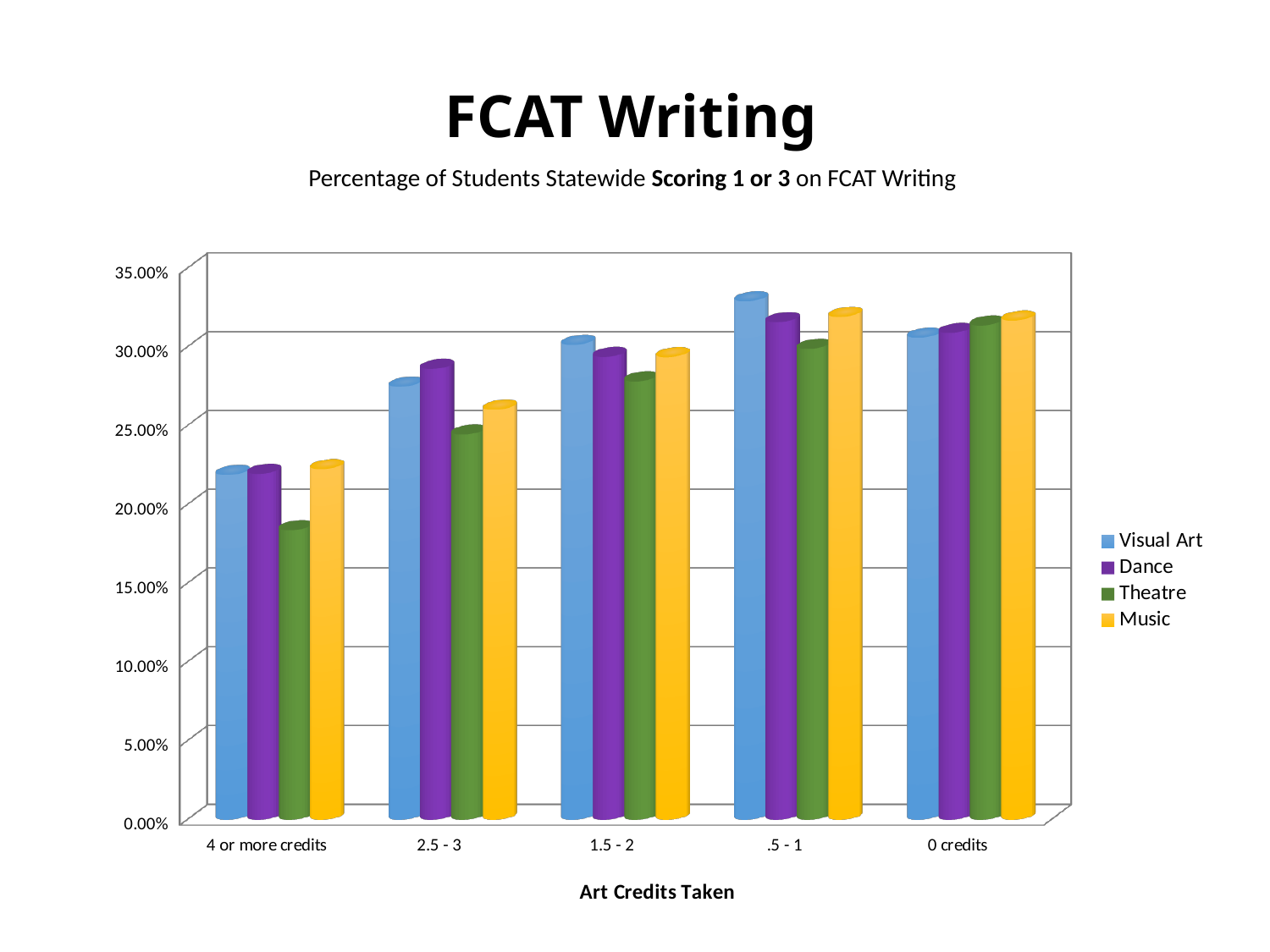
Is the value for Visual Art at .5 - 1 credits greater or less than 30.00%? greater Which series has the lowest value in the 4 or more credits category? Theatre How many series does the legend list? 4 Which series is shown in yellow in the legend? Music In the 2.5 - 3 credits category, which is larger: Visual Art or Theatre? Visual Art How many art-credit categories are shown on the x axis? 5 What kind of chart is shown on the slide? bar chart In which credit category does Visual Art reach its highest value? .5 - 1 Is the value for Theatre at 4 or more credits greater or less than 20.00%? less Do the Theatre values rise or fall moving from 4 or more credits to 0 credits along the x axis? rise Is the value for Music at 2.5 - 3 credits greater or less than 25.00%? greater What is the title of the x axis? Art Credits Taken